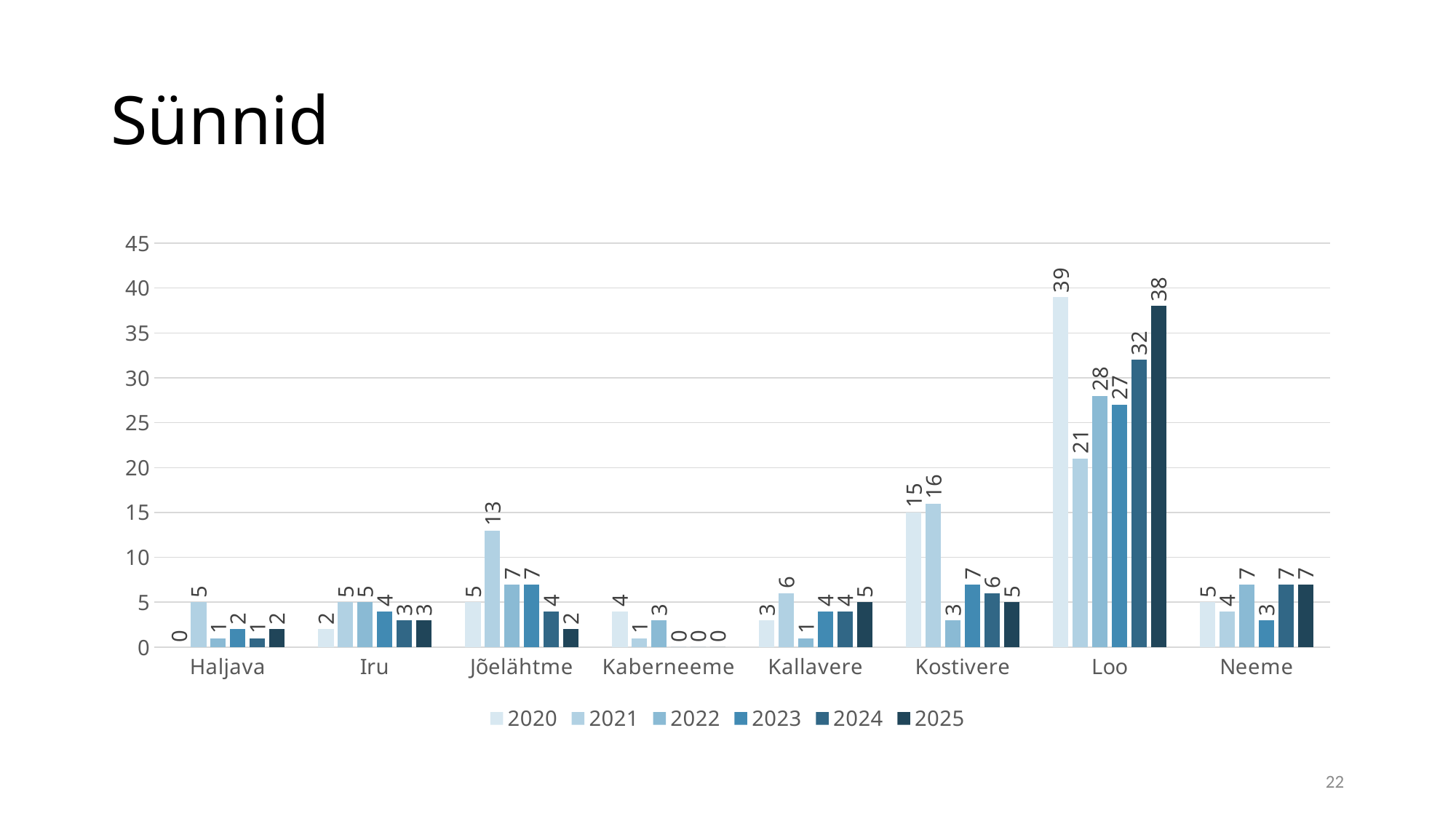
What is the difference between the 2020 and 2021 values for Loo? 18 How many series does the legend list? 6 What is the value for Jõelähtme in 2021? 13 What is the value for Kostivere in 2022? 3 Which is larger for Kostivere: the 2020 value or the 2021 value? 2021 How many categories are shown on the x axis? 8 What is the value for Loo in 2020? 39 What is the title of the slide? Sünnid What kind of chart is shown on the slide? Bar chart What is the value for Kaberneeme in 2025? 0 Which category has the highest value in 2025? Loo Which category has the lowest value in 2020? Haljava